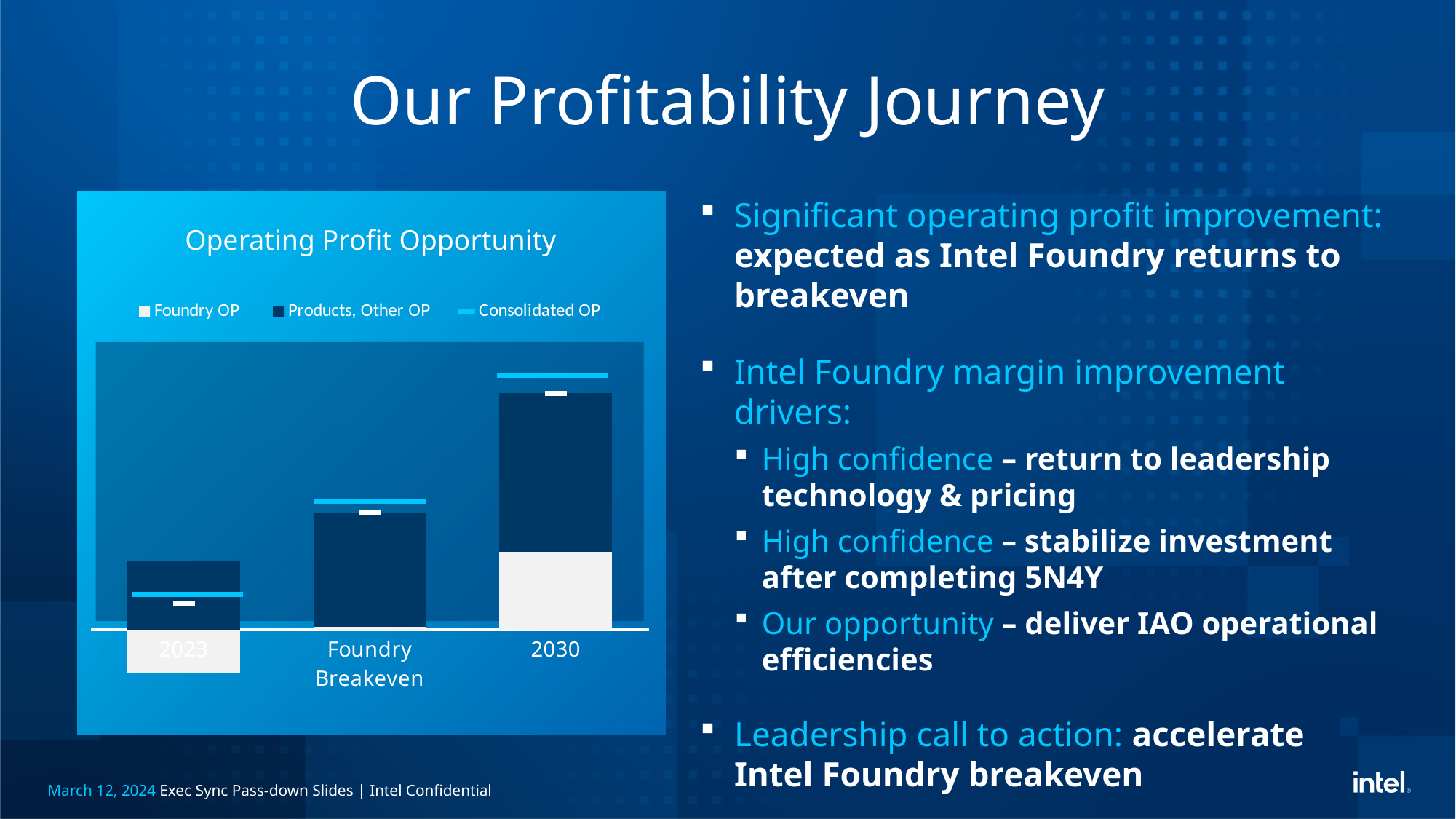
How many categories are shown along the x axis of the chart? 3 Which series is shown as a light blue line marker rather than a bar? Consolidated OP How many series does the chart legend list? 3 Which category is labelled between 2023 and 2030 on the x axis? Foundry Breakeven What kind of chart is shown on the slide? Bar chart Which is larger, the Foundry OP bar for 2030 or for Foundry Breakeven? 2030 Which category has the highest Consolidated OP marker? 2030 In which category does the Foundry OP bar fall below the baseline? 2023 Does the Consolidated OP rise or fall from 2023 to 2030? Rise What is the title of the chart? Operating Profit Opportunity Which is larger, the Products, Other OP bar for 2030 or for 2023? 2030 Which category has the lowest Consolidated OP marker? 2023